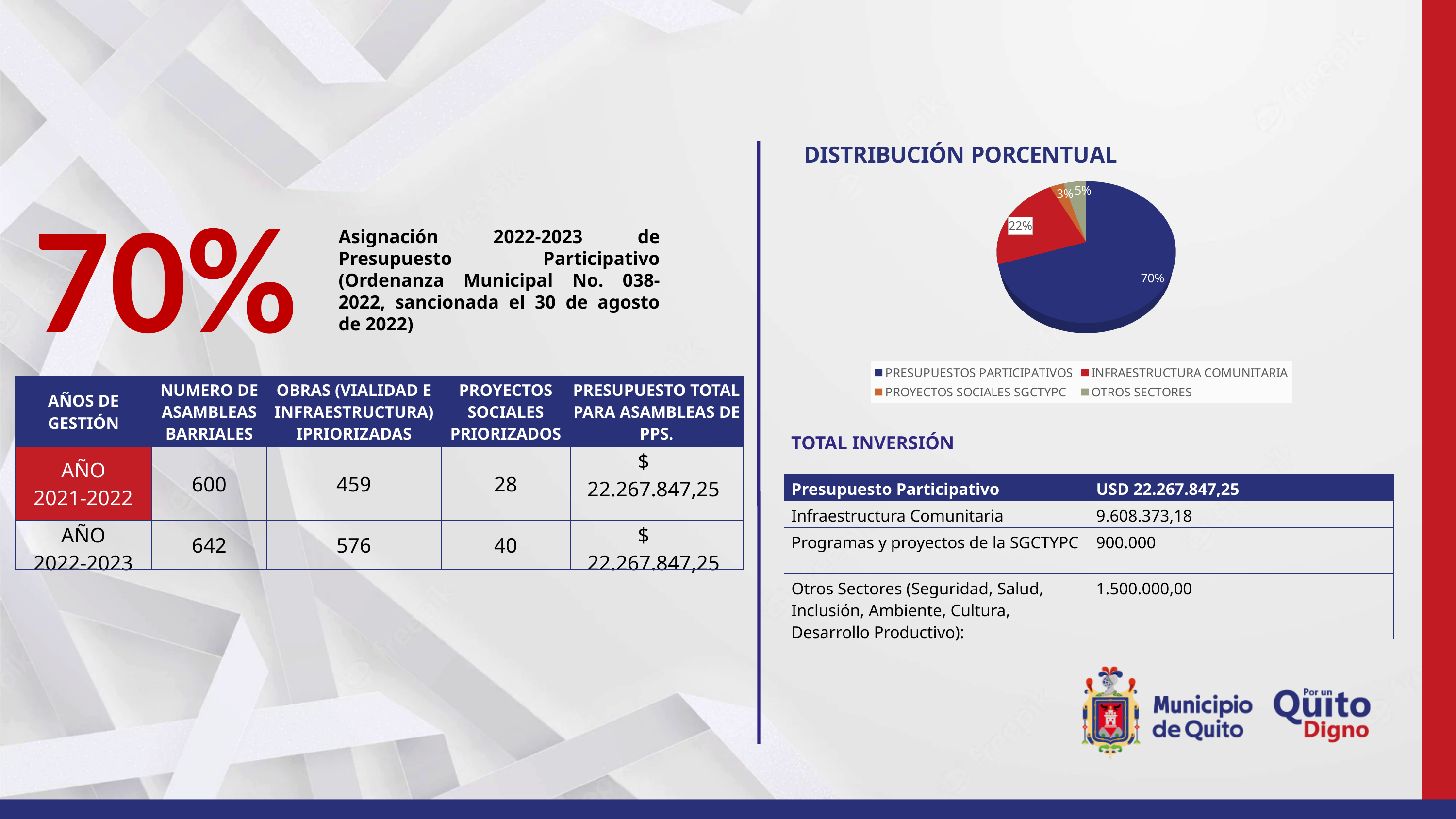
What kind of chart is shown under the title DISTRIBUCIÓN PORCENTUAL? Pie chart What percentage does the pie chart show for PRESUPUESTOS PARTICIPATIVOS? 70% In the pie chart, which is larger: OTROS SECTORES or PROYECTOS SOCIALES SGCTYPC? OTROS SECTORES Which category has the largest slice in the pie chart? PRESUPUESTOS PARTICIPATIVOS In the pie chart, what is the difference in percentage points between PRESUPUESTOS PARTICIPATIVOS and INFRAESTRUCTURA COMUNITARIA? 48 Which category has the smallest slice in the pie chart? PROYECTOS SOCIALES SGCTYPC How many entries does the legend of the pie chart list? 4 What percentage does the pie chart show for PROYECTOS SOCIALES SGCTYPC? 3% How many slices does the pie chart have? 4 What percentage does the pie chart show for INFRAESTRUCTURA COMUNITARIA? 22% What percentage does the pie chart show for OTROS SECTORES? 5% What colour is the PRESUPUESTOS PARTICIPATIVOS slice in the pie chart? Dark blue